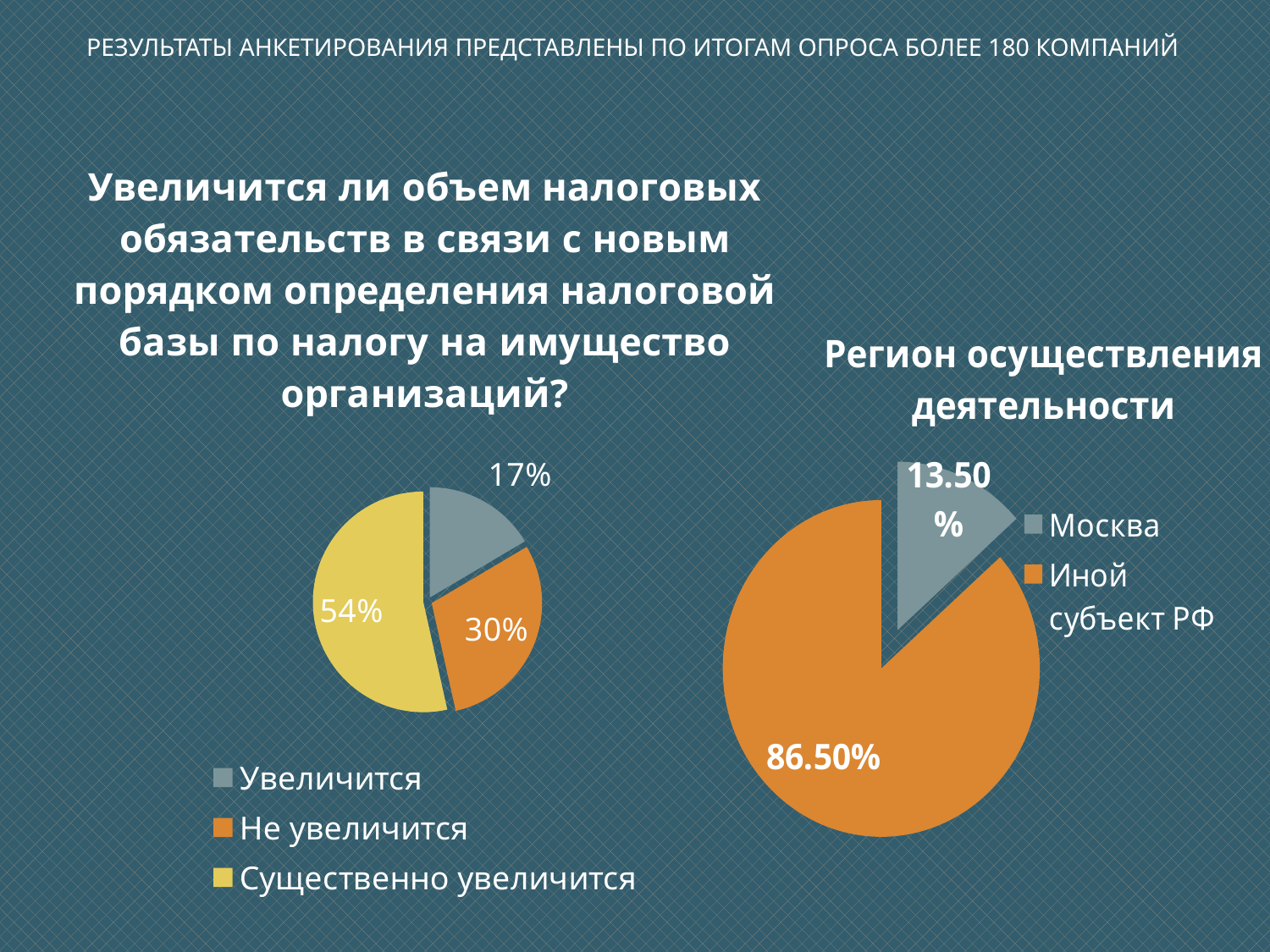
In the right chart ("Регион осуществления деятельности"), which region has the larger share: "Москва" or "Иной субъект РФ"? Иной субъект РФ In the left chart ("Увеличится ли объем налоговых обязательств..."), what share of respondents answered "Не увеличится"? 30% In the right chart ("Регион осуществления деятельности"), what share of respondents are from "Москва"? 13.50% In the left chart ("Увеличится ли объем налоговых обязательств..."), what is the difference in percentage points between "Существенно увеличится" and "Не увеличится"? 24 percentage points In the left chart ("Увеличится ли объем налоговых обязательств..."), which answer has the largest share? Существенно увеличится In the right chart ("Регион осуществления деятельности"), what share of respondents are from "Иной субъект РФ"? 86.50% In the left chart ("Увеличится ли объем налоговых обязательств..."), which answer has the smallest share? Увеличится In the left chart ("Увеличится ли объем налоговых обязательств..."), what share of respondents answered "Существенно увеличится"? 54% In the right chart ("Регион осуществления деятельности"), what colour is the "Москва" slice? Grey In the left chart ("Увеличится ли объем налоговых обязательств..."), what share of respondents answered "Увеличится"? 17% In the left chart ("Увеличится ли объем налоговых обязательств..."), how many slices does the pie have? 3 What type of chart is the right chart ("Регион осуществления деятельности")? Pie chart